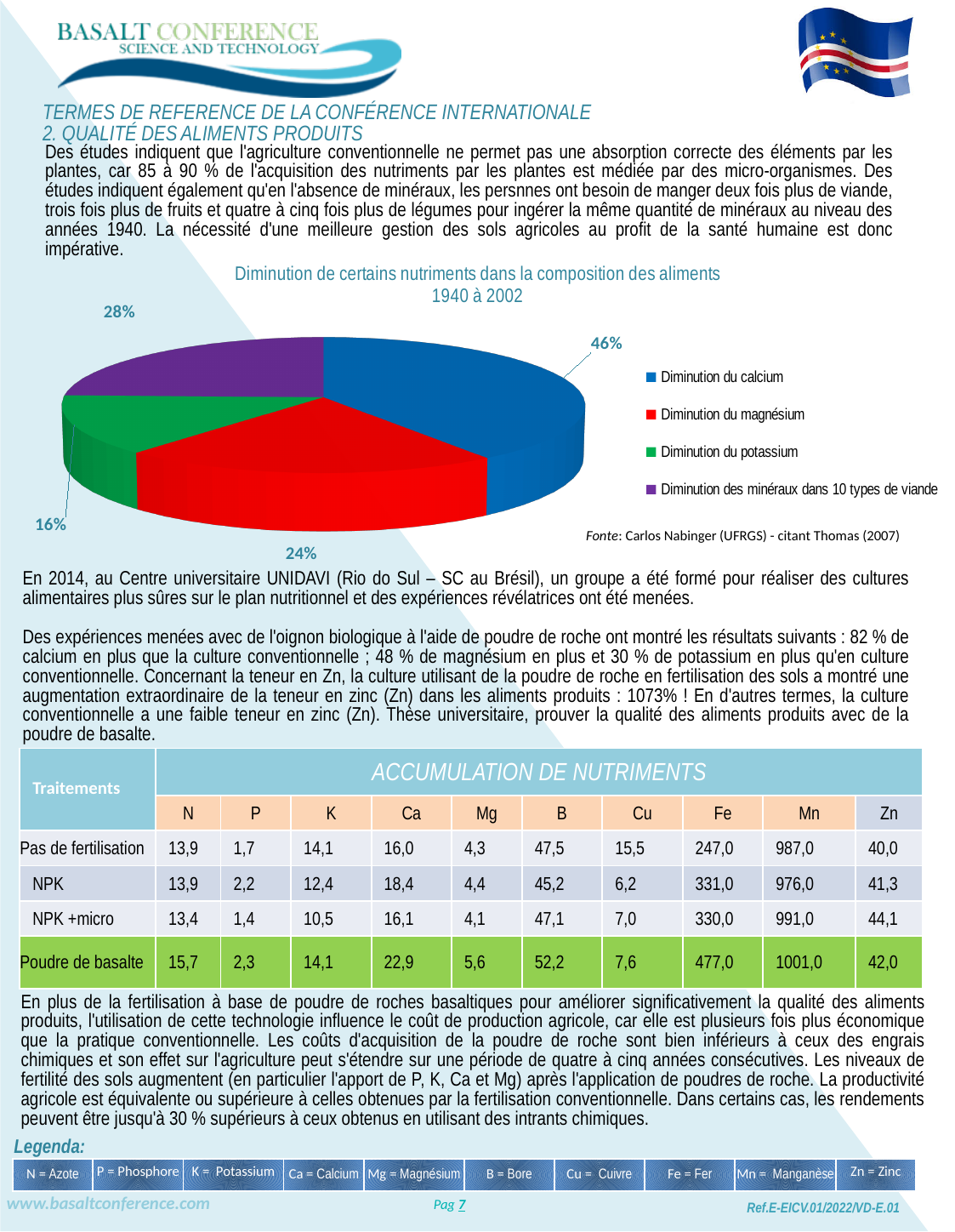
Which category has the smallest slice in the pie chart? Diminution du potassium What is the title of the pie chart? Diminution de certains nutriments dans la composition des aliments 1940 à 2002 What is the value shown for "Diminution du magnésium" in the pie chart? 24% What kind of chart is shown on the slide? pie chart What is the value shown for "Diminution du calcium" in the pie chart? 46% How many entries does the pie chart's legend list? 4 What is the value shown for "Diminution des minéraux dans 10 types de viande" in the pie chart? 28% Which is larger: the value for "Diminution du magnésium" or the value for "Diminution des minéraux dans 10 types de viande"? Diminution des minéraux dans 10 types de viande How many slices does the pie chart have? 4 What is the value shown for "Diminution du potassium" in the pie chart? 16% Which category has the largest slice in the pie chart? Diminution du calcium What is the difference between the values for "Diminution du calcium" and "Diminution du magnésium"? 22%